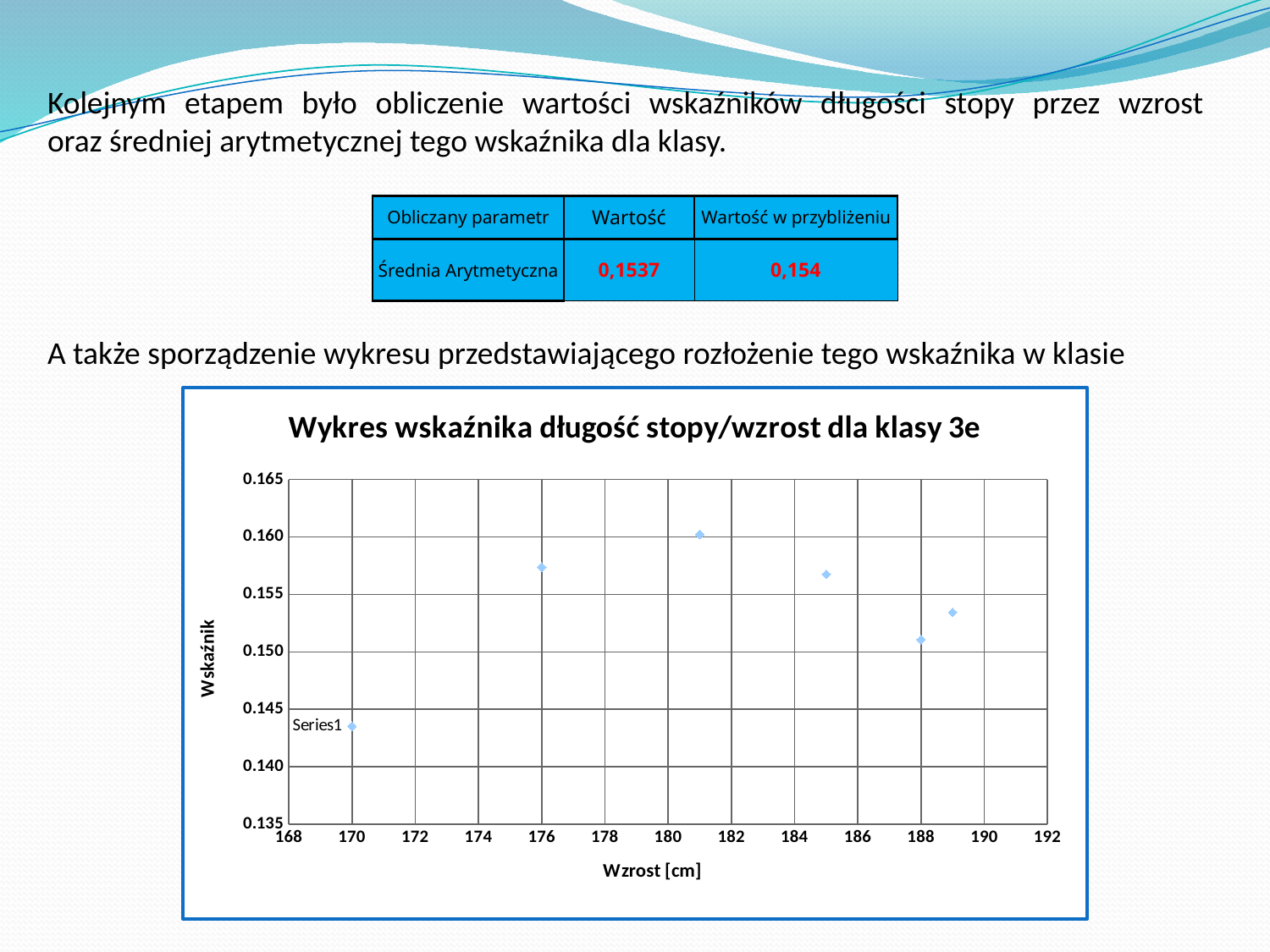
What kind of chart is shown on the slide? scatter chart Is the Wskaźnik value for the point at 181 cm greater or less than 0.155? greater What is the label of the x axis of the chart? Wzrost [cm] Is the Wskaźnik value for the point at 188 cm greater or less than 0.150? greater At which height (Wzrost) is the lowest Wskaźnik value plotted? 170 How many data points are plotted on the chart? 6 Which point has the larger Wskaźnik value: the one at 188 cm or the one at 189 cm? 189 cm At which height (Wzrost) is the highest Wskaźnik value plotted? 181 Is the Wskaźnik value for the point at 170 cm greater or less than 0.145? less What is the title of the chart? Wykres wskaźnika długość stopy/wzrost dla klasy 3e Which point has the larger Wskaźnik value: the one at 176 cm or the one at 181 cm? 181 cm